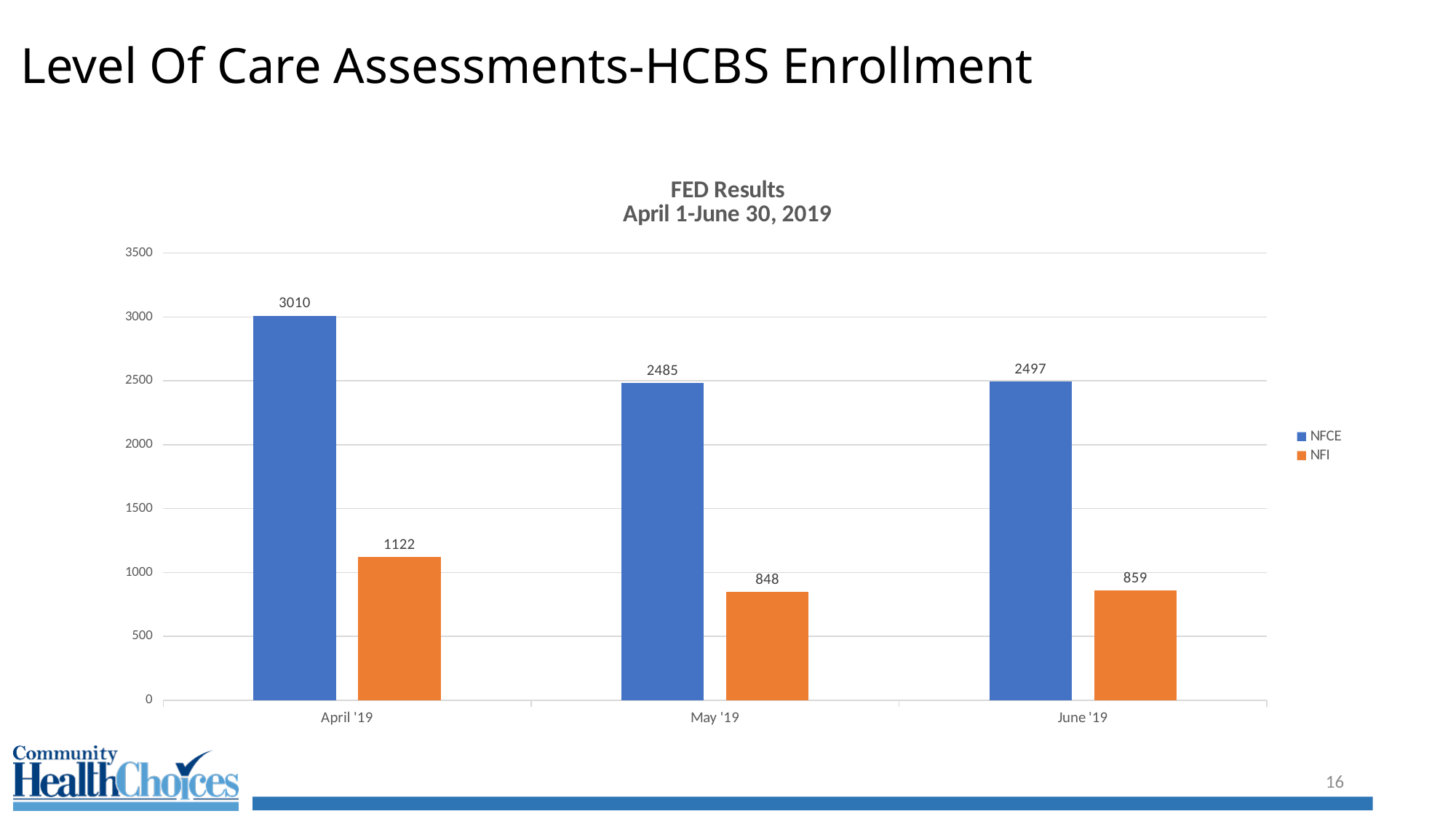
How many series does the legend list? 2 What is the NFI value for May '19? 848 Which month has the lowest NFI value? May '19 Which month has the highest NFCE value? April '19 What is the difference between the NFCE and NFI values for April '19? 1888 How many months are shown on the x axis? 3 What kind of chart is shown on the slide? Bar chart What is the NFI value for June '19? 859 What is the difference between the NFCE values for April '19 and May '19? 525 What is the NFCE value for April '19? 3010 Which is larger, the NFI value for April '19 or the NFI value for June '19? April '19 What is the title of the chart? FED Results April 1-June 30, 2019